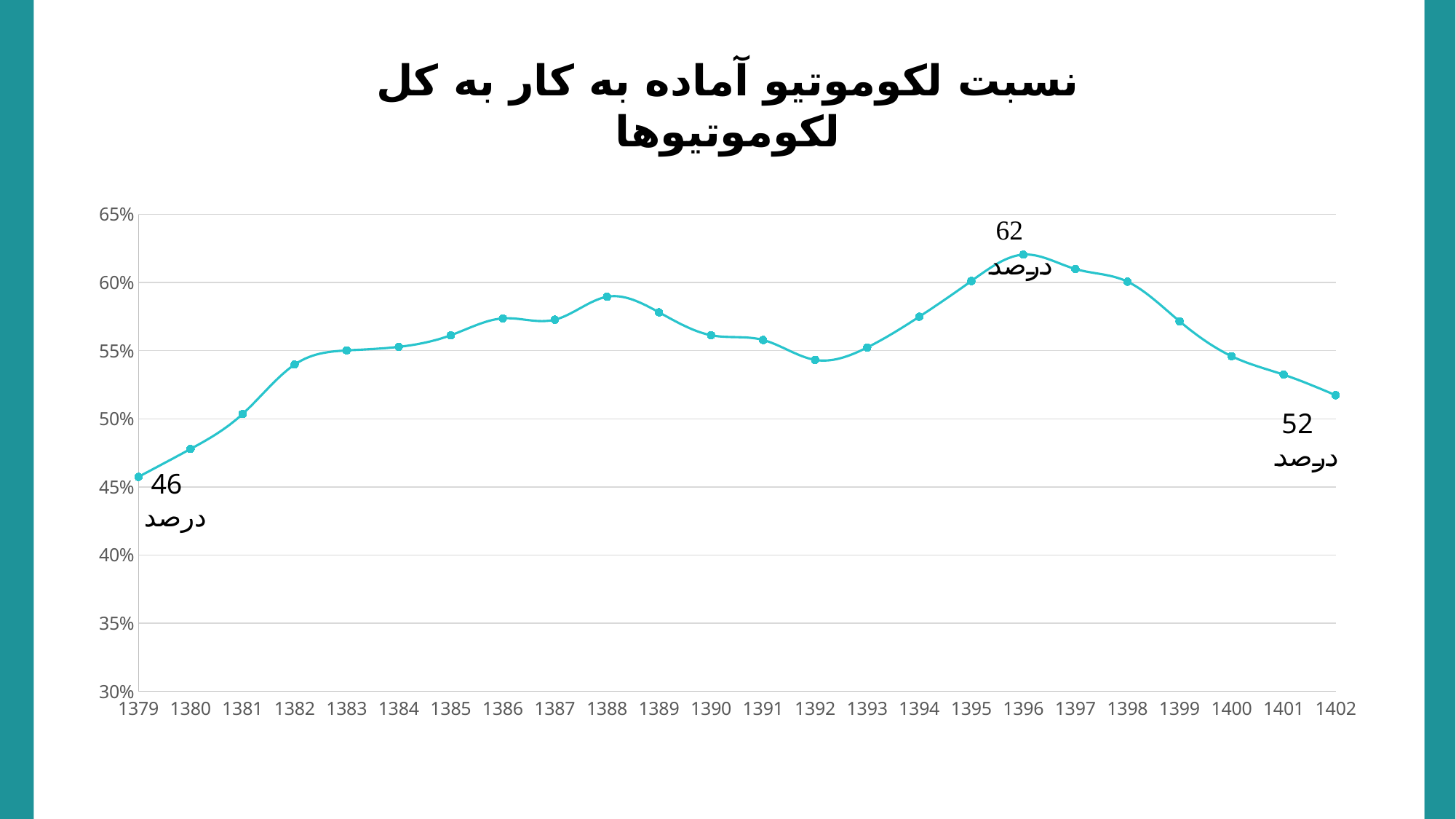
What kind of chart is shown on the slide? Line chart What value is labelled for the year 1402? 52 درصد How many years are plotted on the x axis? 24 What value is labelled for the year 1379? 46 درصد What value is labelled for the year 1396? 62 درصد What is the difference between the labelled values for 1396 and 1379? 16 percentage points Is the value for 1380 greater or less than 50%? less Which year has the lowest value on the chart? 1379 Do the values rise or fall from 1396 to 1402? fall Which year has the highest value on the chart? 1396 Which year has the larger value, 1388 or 1392? 1388 Is the value for 1388 greater or less than 55%? greater